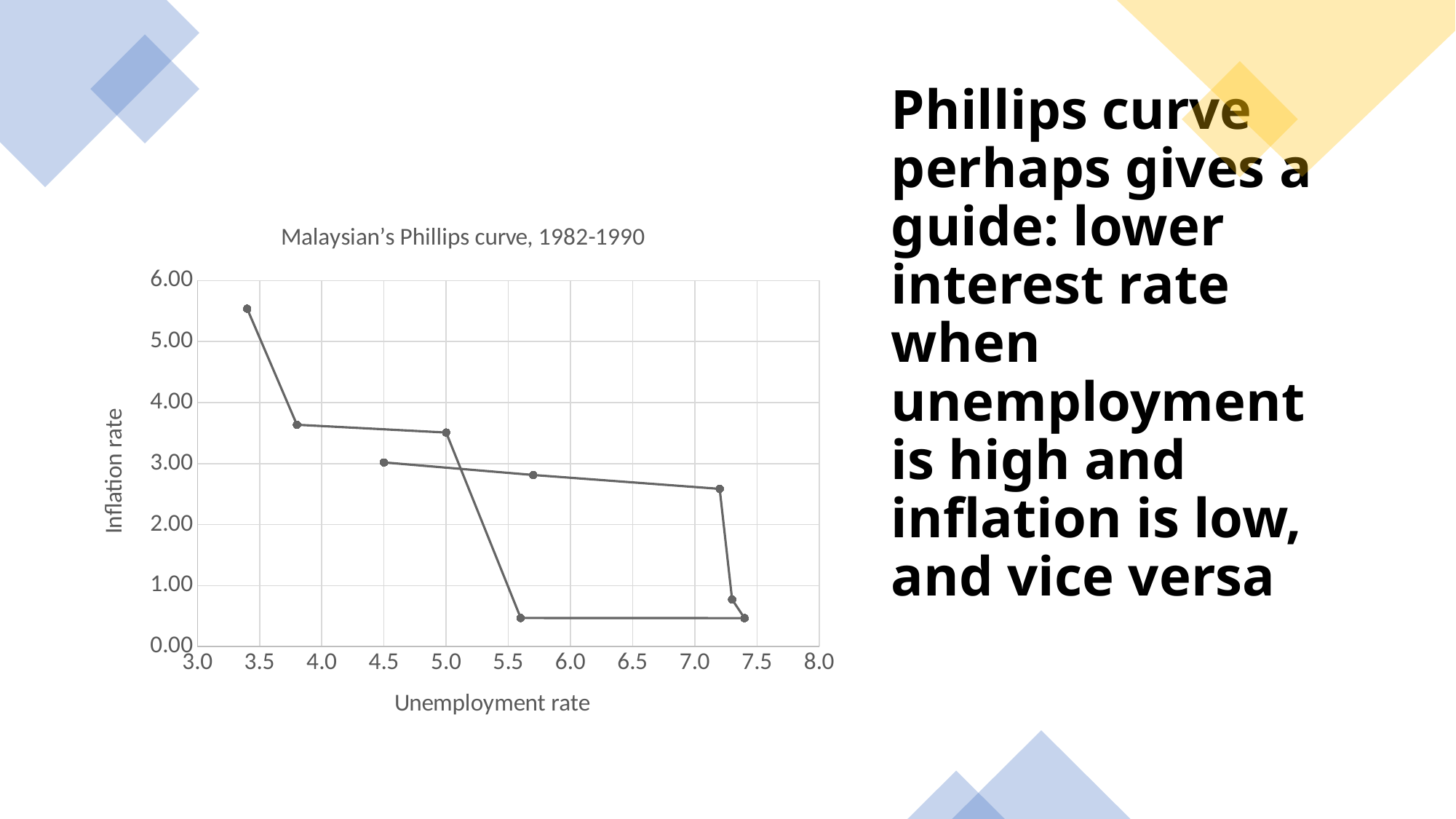
Is the inflation rate for the rightmost point (highest unemployment rate) greater or less than 1.00? less What is the label of the vertical axis? Inflation rate Is the highest inflation rate plotted greater or less than 5.00? greater What kind of chart is shown on the slide? Line chart (scatter with connected points) Is the unemployment rate of the leftmost point greater or less than 3.5? less How many data points are plotted on the chart? 9 How many plotted points have an inflation rate above 4.00? 1 How many plotted points have an inflation rate below 1.00? 3 What is the title of the chart? Malaysian's Phillips curve, 1982-1990